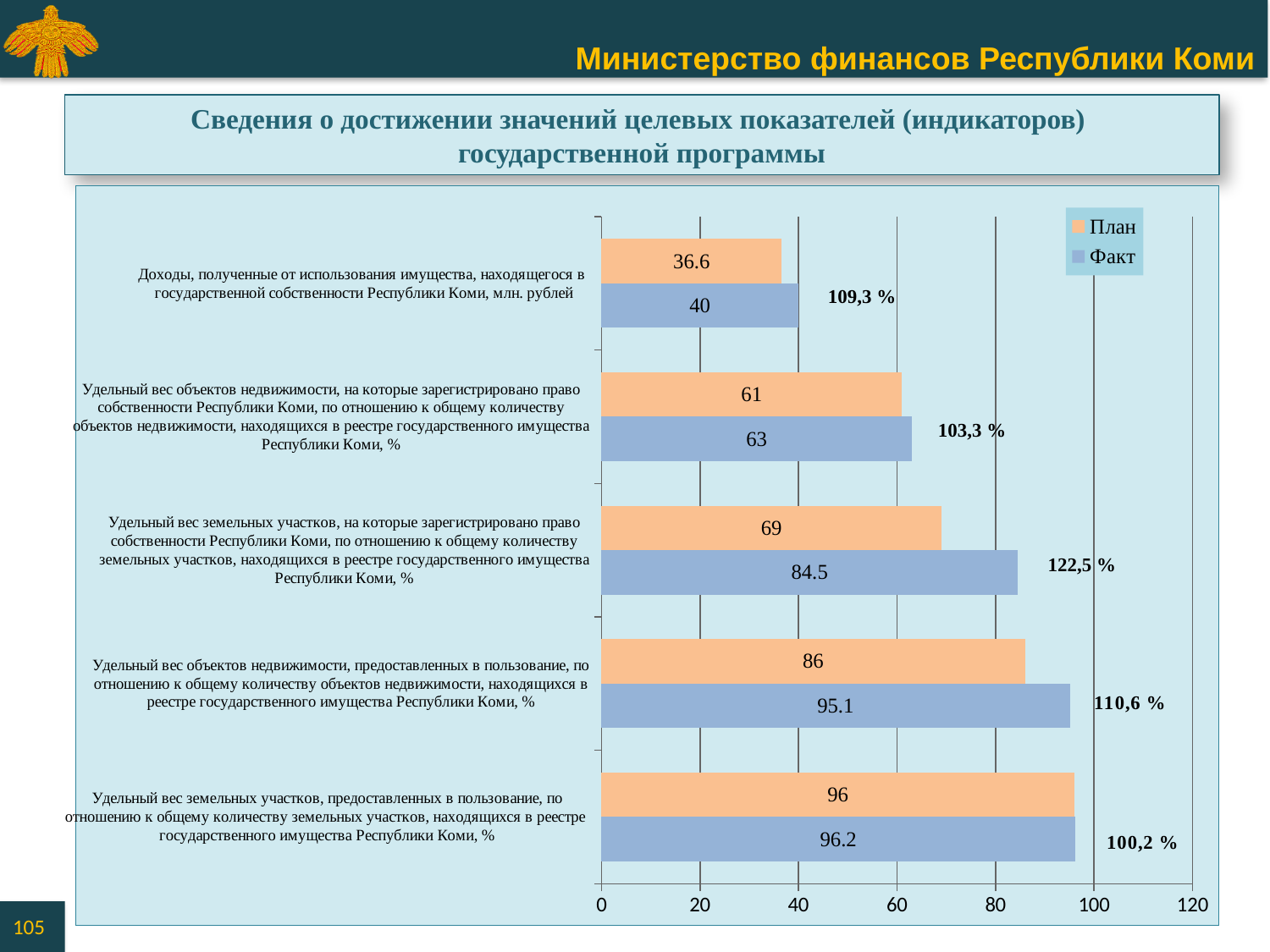
What is the План value for 'Удельный вес объектов недвижимости, предоставленных в пользование'? 86 What is the Факт (actual) value for 'Доходы, полученные от использования имущества, находящегося в государственной собственности Республики Коми, млн. рублей'? 40 What is the План (plan) value for 'Доходы, полученные от использования имущества, находящегося в государственной собственности Республики Коми, млн. рублей'? 36.6 Which category has the lowest План value? Доходы, полученные от использования имущества, находящегося в государственной собственности Республики Коми, млн. рублей What is the difference between the Факт and План values for 'Удельный вес земельных участков, на которые зарегистрировано право собственности Республики Коми'? 15.5 How many series does the legend list? 2 Which is larger for 'Удельный вес объектов недвижимости, предоставленных в пользование': the План value or the Факт value? Факт What percentage of plan achievement is shown next to the bars for 'Удельный вес земельных участков, на которые зарегистрировано право собственности Республики Коми'? 122,5 % How many categories are shown on the chart? 5 What is the Факт value for 'Удельный вес земельных участков, на которые зарегистрировано право собственности Республики Коми'? 84.5 Which category has the highest Факт value? Удельный вес земельных участков, предоставленных в пользование, по отношению к общему количеству земельных участков, находящихся в реестре государственного имущества Республики Коми, % What type of chart is shown on the slide? Bar chart